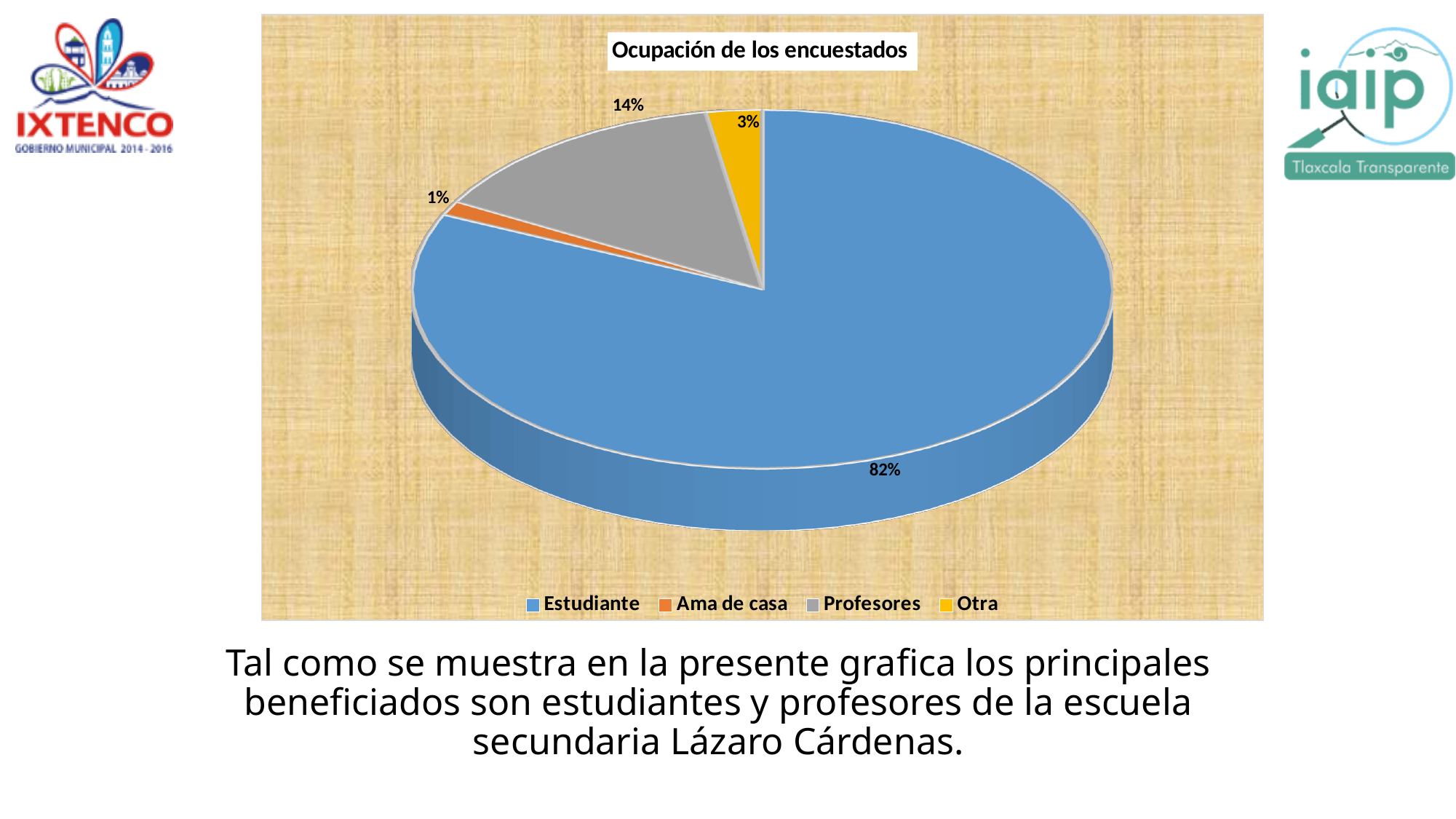
What share of the pie does Estudiante represent? 82% What share of the pie does Otra represent? 3% Which is larger, the share for Otra or the share for Ama de casa? Otra How many categories does the pie chart show? 4 Which category has the smallest slice of the pie? Ama de casa What is the title of the chart? Ocupación de los encuestados Which colour represents Profesores in the legend? Grey Which category has the largest slice of the pie? Estudiante What share of the pie does Profesores represent? 14% What kind of chart is shown on the slide? Pie chart What is the difference in percentage points between Estudiante and Profesores? 68